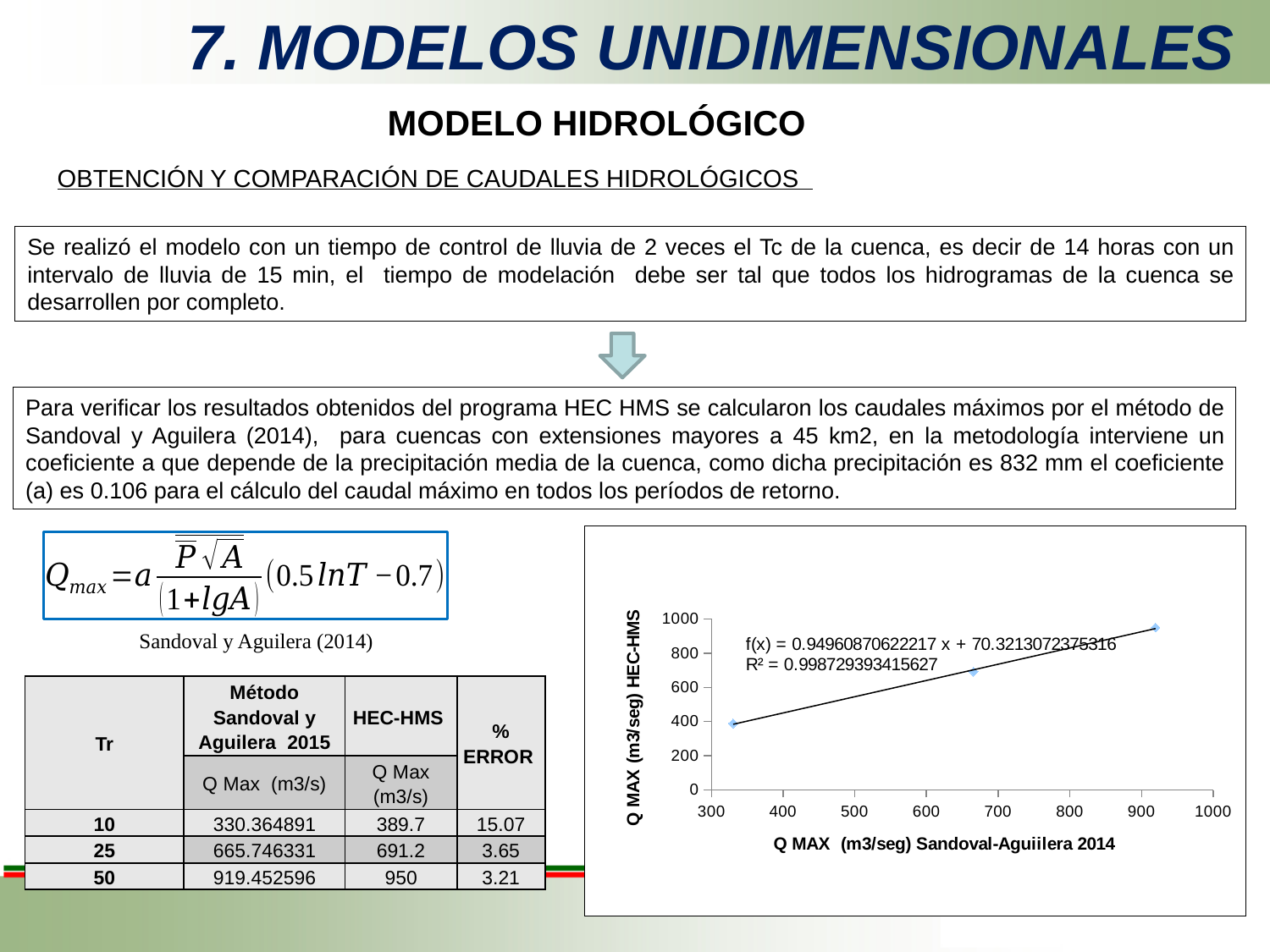
How many data points are plotted in the scatter chart? 3 Is the HEC-HMS value (y) of the rightmost point greater or less than 800? greater Do the plotted points rise or fall as the x-axis value increases? rise What is the title of the x-axis of the chart? Q MAX (m3/seg) Sandoval-Aguiilera 2014 Is the HEC-HMS value (y) of the middle point greater or less than 600? greater What is the highest tick value shown on the y-axis? 1000 Which point has the highest HEC-HMS value: the leftmost, the middle, or the rightmost? rightmost What is the lowest tick value shown on the x-axis? 300 What kind of chart is shown on the slide? scatter chart What is the R² value shown on the chart? 0.998729393415627 Is the Sandoval-Aguilera value (x) of the leftmost point greater or less than 400? less